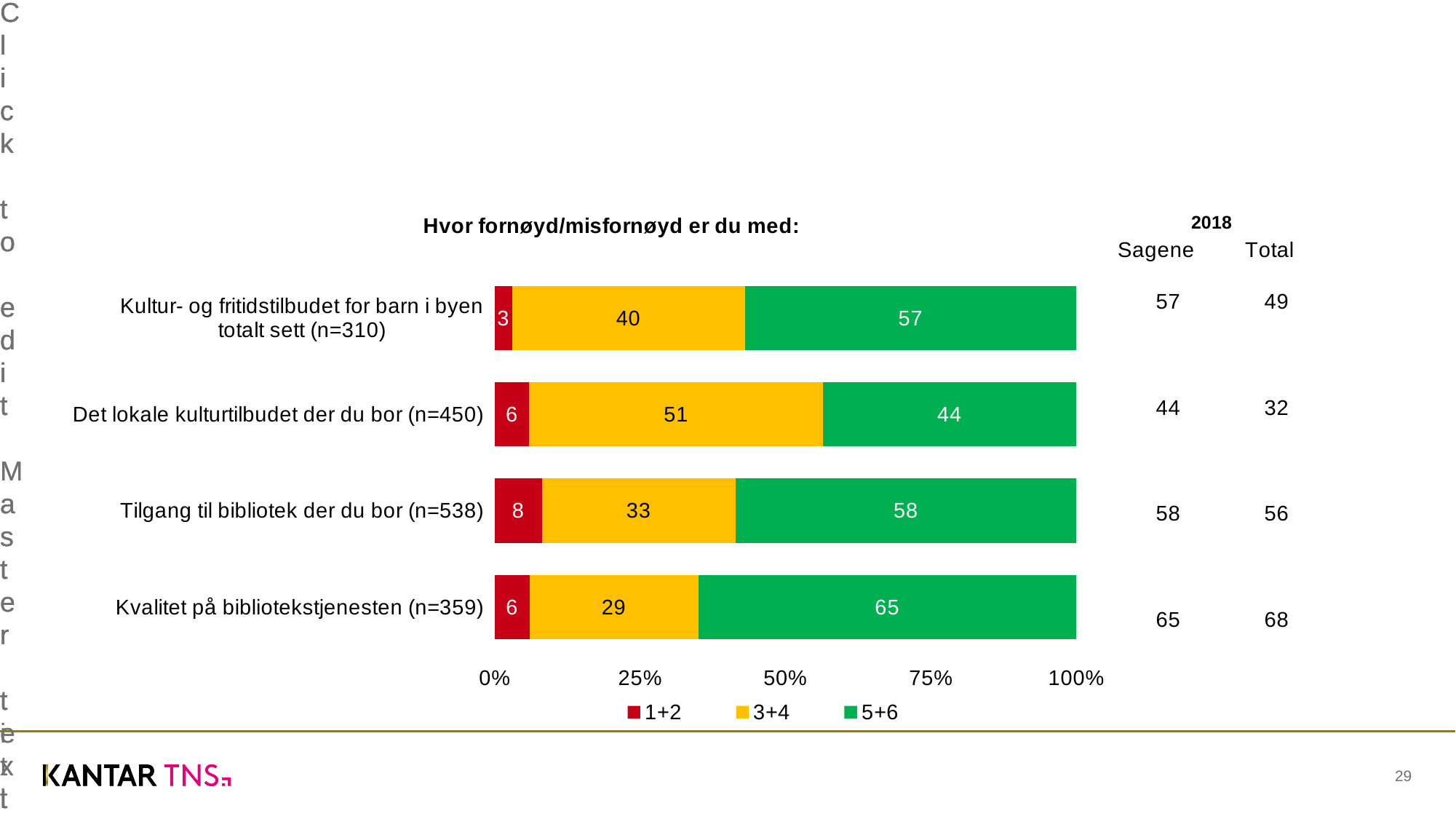
Which category has the highest value for the 5+6 series? Kvalitet på bibliotekstjenesten (n=359) Which category has the lowest value for the 1+2 series? Kultur- og fritidstilbudet for barn i byen totalt sett (n=310) What is the value of the 1+2 series for "Tilgang til bibliotek der du bor (n=538)"? 8 How many categories are shown in the chart? 4 Which is larger: the 5+6 value for "Tilgang til bibliotek der du bor (n=538)" or for "Det lokale kulturtilbudet der du bor (n=450)"? Tilgang til bibliotek der du bor (n=538) What kind of chart is shown on the slide? Stacked bar chart What is the total of the stacked bar for "Kultur- og fritidstilbudet for barn i byen totalt sett (n=310)"? 100 How many series does the legend list? 3 What is the value of the 5+6 series for "Kvalitet på bibliotekstjenesten (n=359)"? 65 What is the value of the 3+4 series for "Det lokale kulturtilbudet der du bor (n=450)"? 51 What is the title of the chart? Hvor fornøyd/misfornøyd er du med: What is the difference between the 3+4 values for "Det lokale kulturtilbudet der du bor (n=450)" and "Kvalitet på bibliotekstjenesten (n=359)"? 22